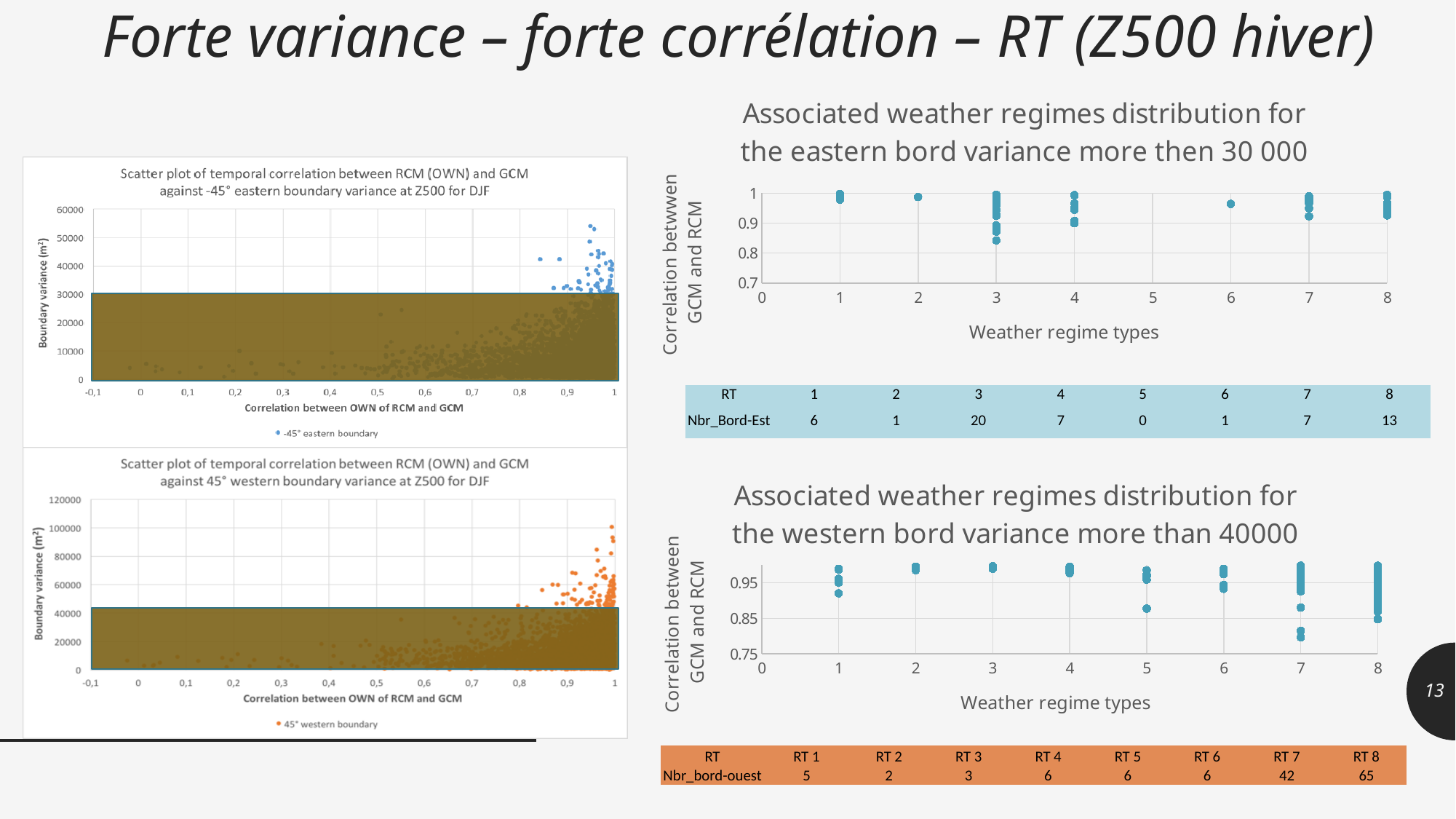
In the top-right chart (eastern bord variance more then 30 000), are the points for weather regime type 1 greater or less than 0.9? greater In the top-left scatter plot for the -45° eastern boundary, is the highest boundary variance value greater or less than 50000? greater According to the table under the top-right chart, which weather regime type has the lowest Nbr_Bord-Est count? 5 What kind of chart is the top-right chart titled 'Associated weather regimes distribution for the eastern bord variance more then 30 000'? Scatter plot In the top-right chart (eastern bord variance more then 30 000), is the lowest point for weather regime type 3 greater or less than 0.9? less According to the table under the bottom-right chart, which weather regime type has the highest Nbr_bord-ouest count? RT 8 According to the table under the top-right chart, how many points (Nbr_Bord-Est) belong to weather regime type 3? 20 What is the x-axis label of the bottom-right chart about the western bord variance more than 40000? Weather regime types What is the legend entry of the top-left scatter plot? -45° eastern boundary